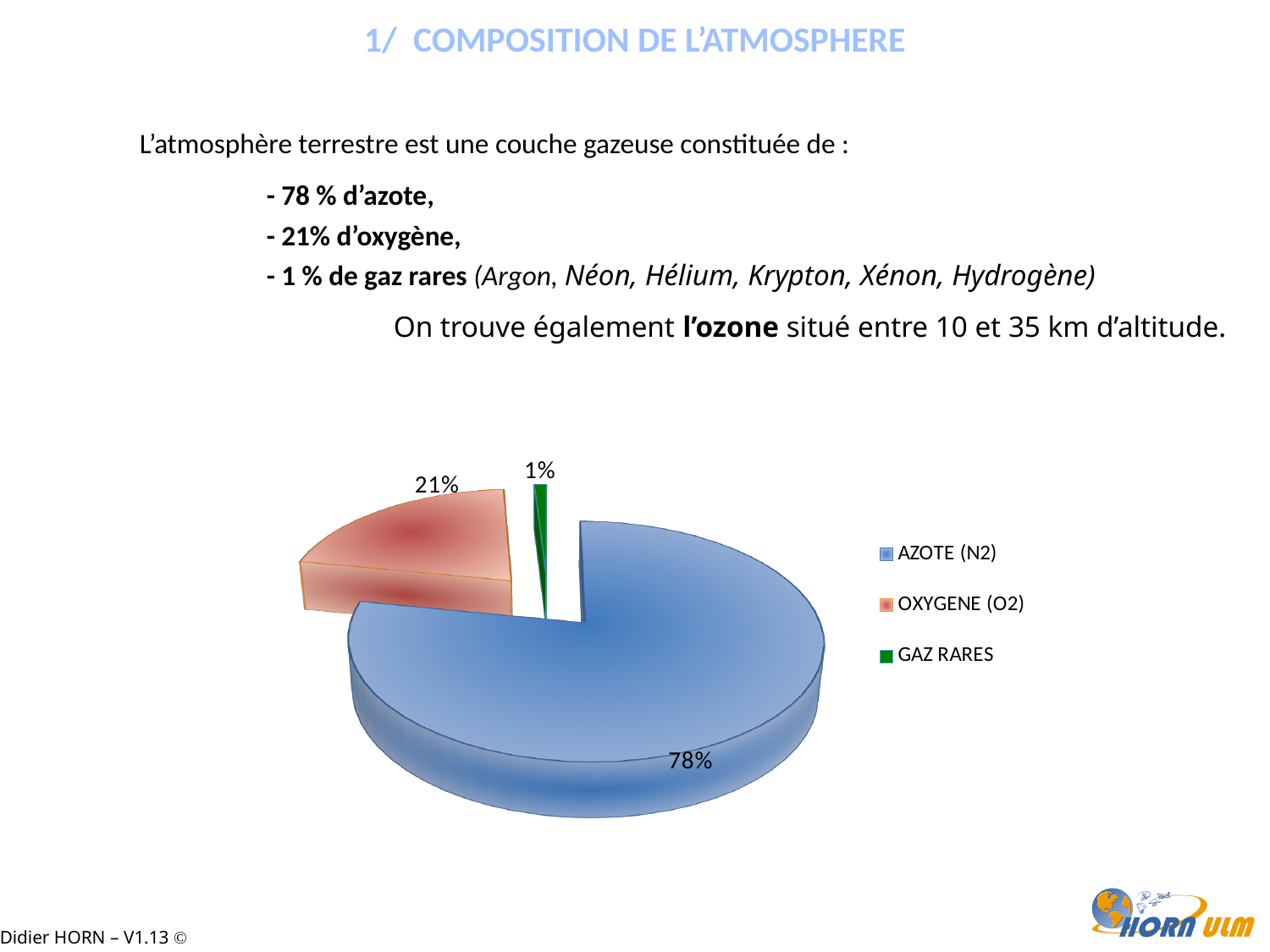
How many entries does the legend list? 3 Which category has the largest slice in the pie chart? AZOTE (N2) What is the value for GAZ RARES in the pie chart? 1% How many slices does the pie chart have? 3 Which is larger, the slice for OXYGENE (O2) or the slice for GAZ RARES? OXYGENE (O2) What is the value for OXYGENE (O2) in the pie chart? 21% Which category has the smallest slice in the pie chart? GAZ RARES What type of chart is shown on the slide? pie chart What colour is the slice for GAZ RARES? green What is the difference between the AZOTE (N2) and OXYGENE (O2) values? 57% What is the difference between the OXYGENE (O2) and GAZ RARES values? 20% What is the value for AZOTE (N2) in the pie chart? 78%